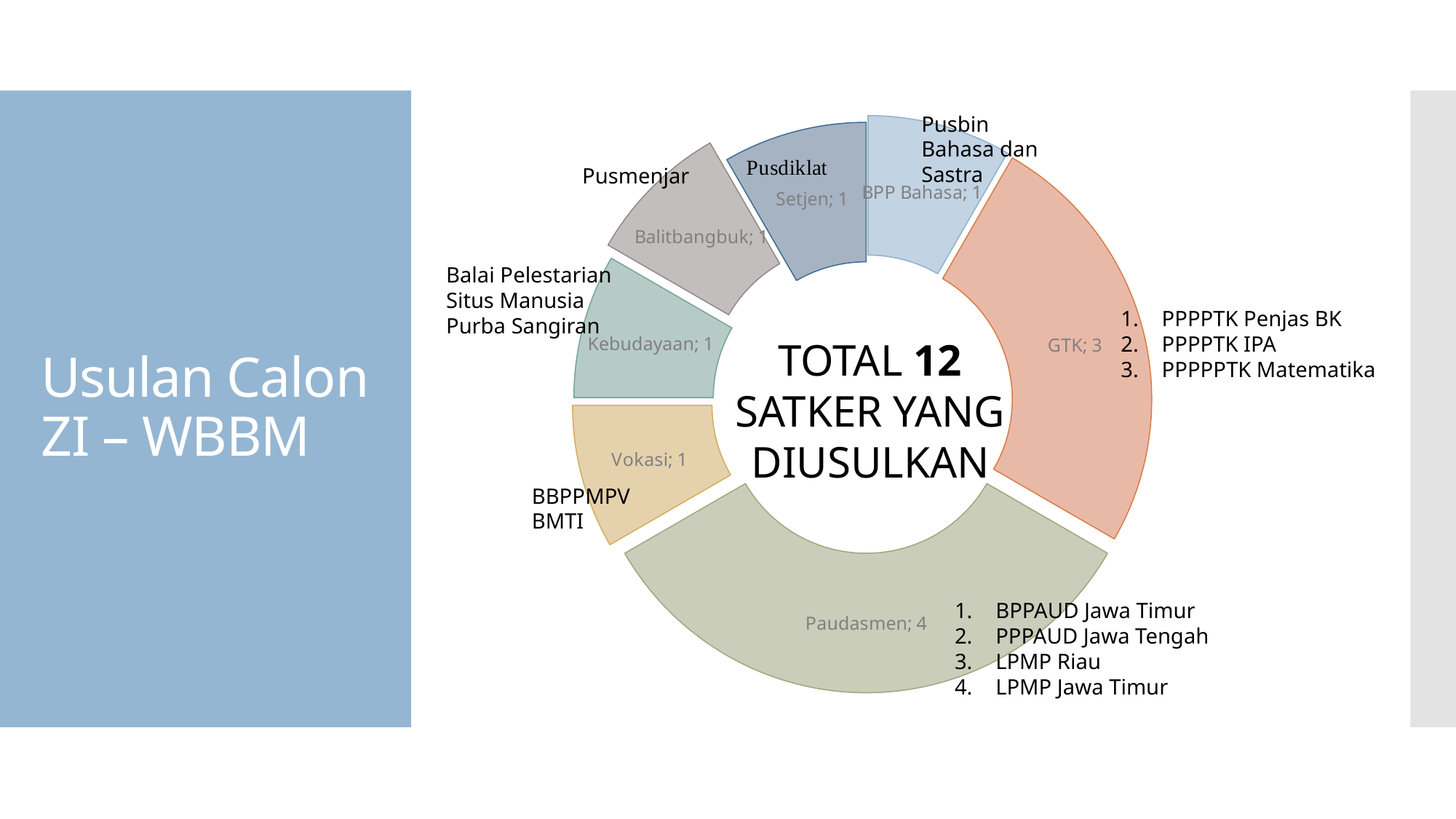
What kind of chart is shown on the slide? doughnut chart What is the value for Vokasi? 1 What is the value for GTK? 3 What share of the total does Paudasmen represent? 4 of 12 (one third) Which is larger, the value for GTK or the value for Setjen? GTK What is the value for Kebudayaan? 1 What text is shown in the centre of the doughnut chart? TOTAL 12 SATKER YANG DIUSULKAN What is the difference between the values for Paudasmen and GTK? 1 How many categories are shown in the chart? 7 What is the value for Paudasmen? 4 Which category has the highest value? Paudasmen What is the total of all the values in the chart? 12